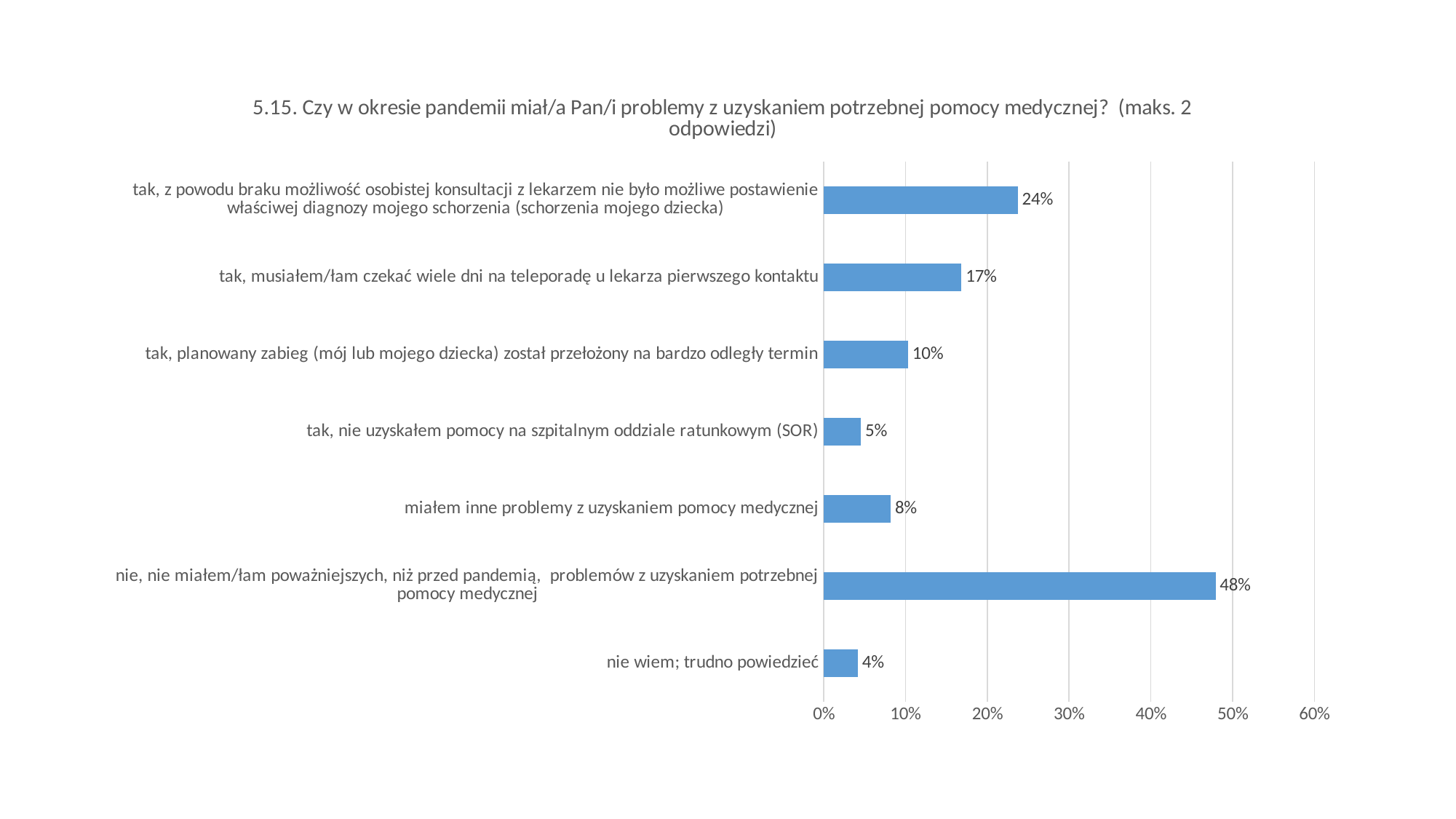
What percentage is shown for "nie wiem; trudno powiedzieć"? 4% What is the maximum value shown on the horizontal axis? 60% How many answer categories are shown in the chart? 7 What type of chart is shown on the slide? Bar chart Which answer category has the lowest percentage? nie wiem; trudno powiedzieć Which is larger: the value for "tak, planowany zabieg ... został przełożony na bardzo odległy termin" or the value for "miałem inne problemy z uzyskaniem pomocy medycznej"? tak, planowany zabieg ... został przełożony na bardzo odległy termin What is the difference in percentage points between the "nie, nie miałem/łam poważniejszych..." category (48%) and the category about lack of in-person consultation preventing a proper diagnosis (24%)? 24 percentage points What percentage of respondents answered "tak, musiałem/łam czekać wiele dni na teleporadę u lekarza pierwszego kontaktu"? 17% What is the value shown for "tak, nie uzyskałem pomocy na szpitalnym oddziale ratunkowym (SOR)"? 5% Which answer category has the highest percentage? nie, nie miałem/łam poważniejszych, niż przed pandemią, problemów z uzyskaniem potrzebnej pomocy medycznej What is the value for "miałem inne problemy z uzyskaniem pomocy medycznej"? 8% Is the value for "nie, nie miałem/łam poważniejszych, niż przed pandemią, problemów z uzyskaniem potrzebnej pomocy medycznej" greater or less than 40%? greater